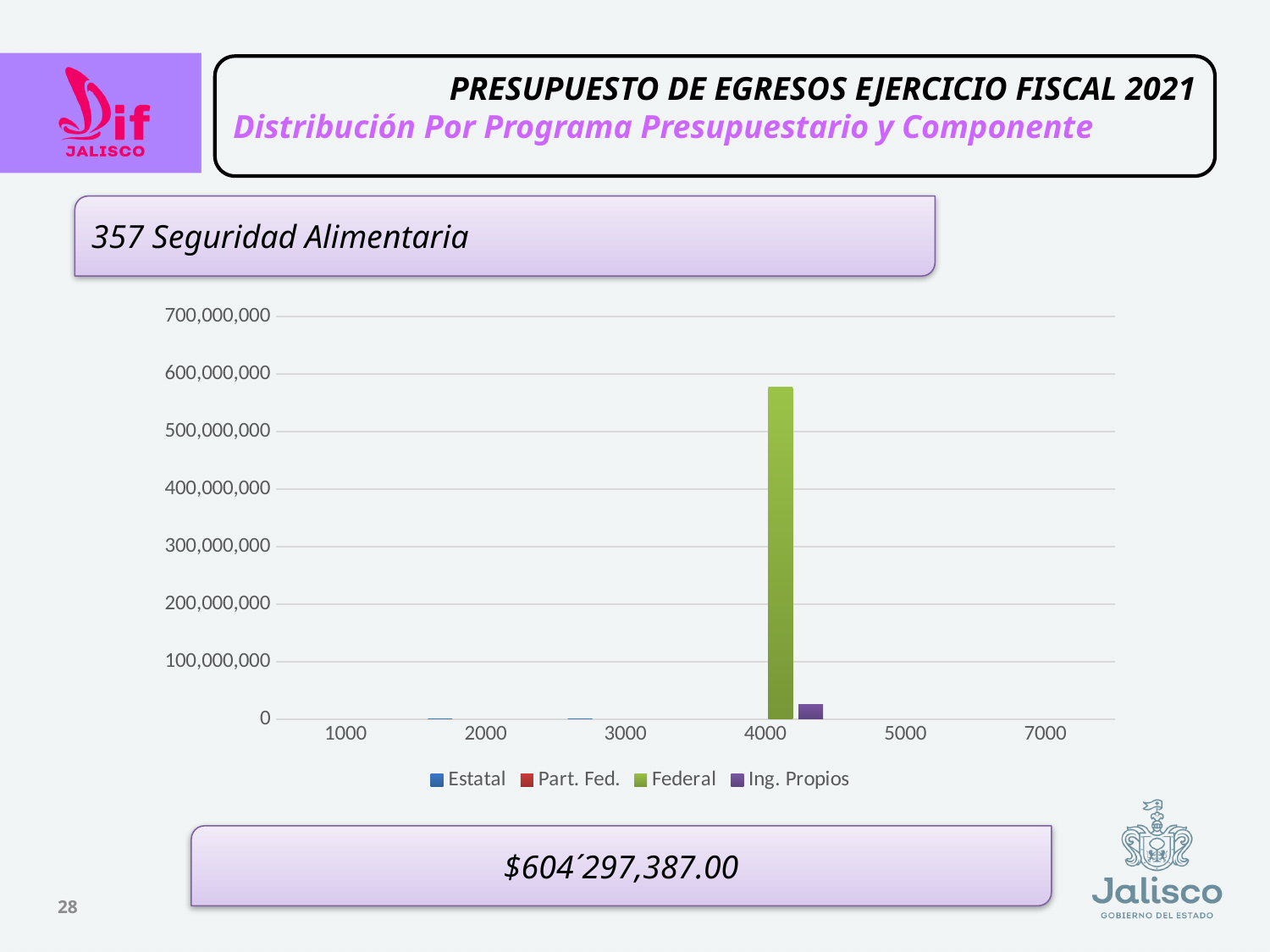
Which x-axis category has the highest bar in the chart? 4000 What is the highest value shown on the chart's y axis? 700,000,000 For category 4000, which is larger: the Federal bar or the Ing. Propios bar? Federal Which series has the tallest bar in the chart? Federal What kind of chart is shown on the slide? bar chart What colour represents the Federal series in the chart legend? green Is the Federal value for category 4000 greater or less than 500,000,000? greater How many categories are shown on the x axis of the chart? 6 Is the Federal value for category 4000 greater or less than 600,000,000? less How many series does the chart legend list? 4 Is the Ing. Propios value for category 4000 greater or less than 100,000,000? less What program title appears above the chart? 357 Seguridad Alimentaria